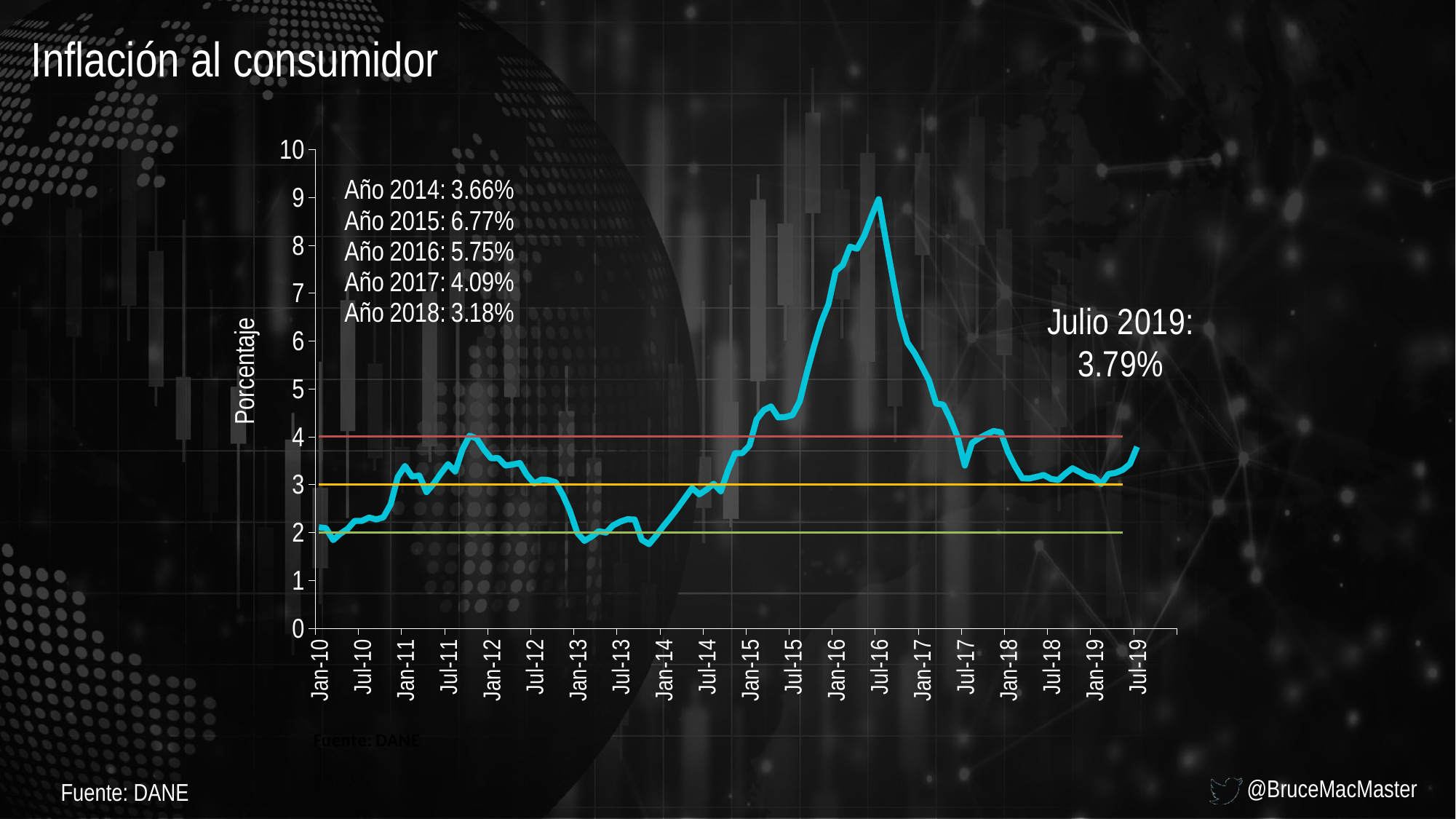
What inflation value is given for Año 2018? 3.18% Is the value of the line at Jul-16 greater or less than 8? greater What inflation value is given for Julio 2019? 3.79% What is the title of the chart on the slide? Inflación al consumidor Which is larger, the inflation value for Año 2016 or for Año 2017? Año 2016 What inflation value is given for Año 2015? 6.77% Which of the annotated years, 2014 to 2018, has the lowest inflation value? Año 2018 What kind of chart is shown on the slide? line chart Does the line rise or fall between Jul-16 and Jul-17? fall What is the label of the vertical axis? Porcentaje Which of the annotated years, 2014 to 2018, has the highest inflation value? Año 2015 What is the difference between the inflation values for Año 2015 and Año 2014? 3.11 percentage points